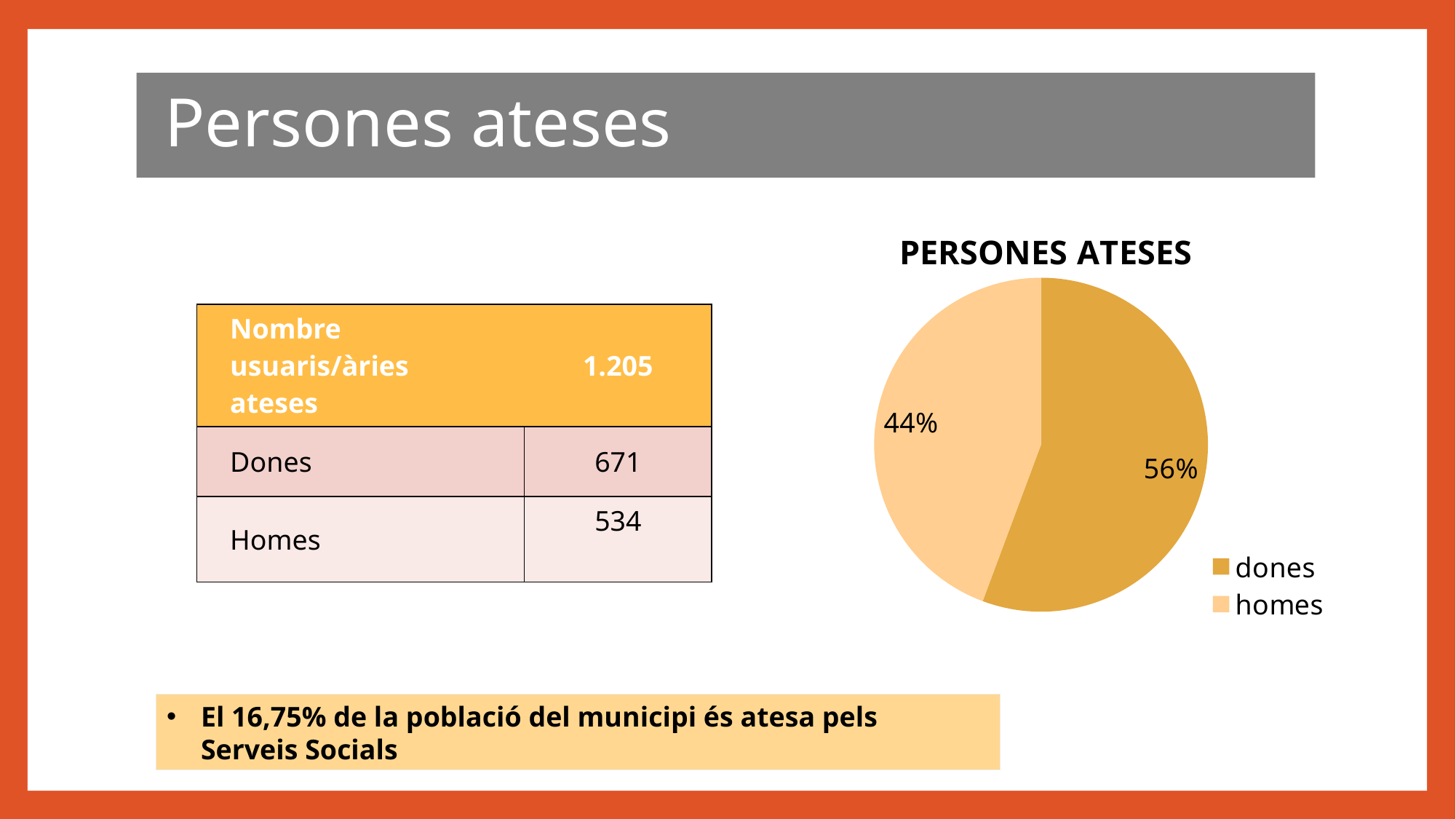
Is the share for 'homes' greater or less than 50%? less How many entries does the legend list? 2 How many slices does the pie chart have? 2 Which slice of the pie chart is the largest? dones What percentage of the pie does the 'dones' slice represent? 56% What percentage of the pie does the 'homes' slice represent? 44% Which legend entry is shown in the lighter colour? homes What is the difference in percentage points between the 'dones' slice and the 'homes' slice? 12 What type of chart is shown on the slide? pie chart Which is larger in the pie chart, the share for 'dones' or the share for 'homes'? dones Which slice of the pie chart is the smallest? homes What is the title of the chart? PERSONES ATESES